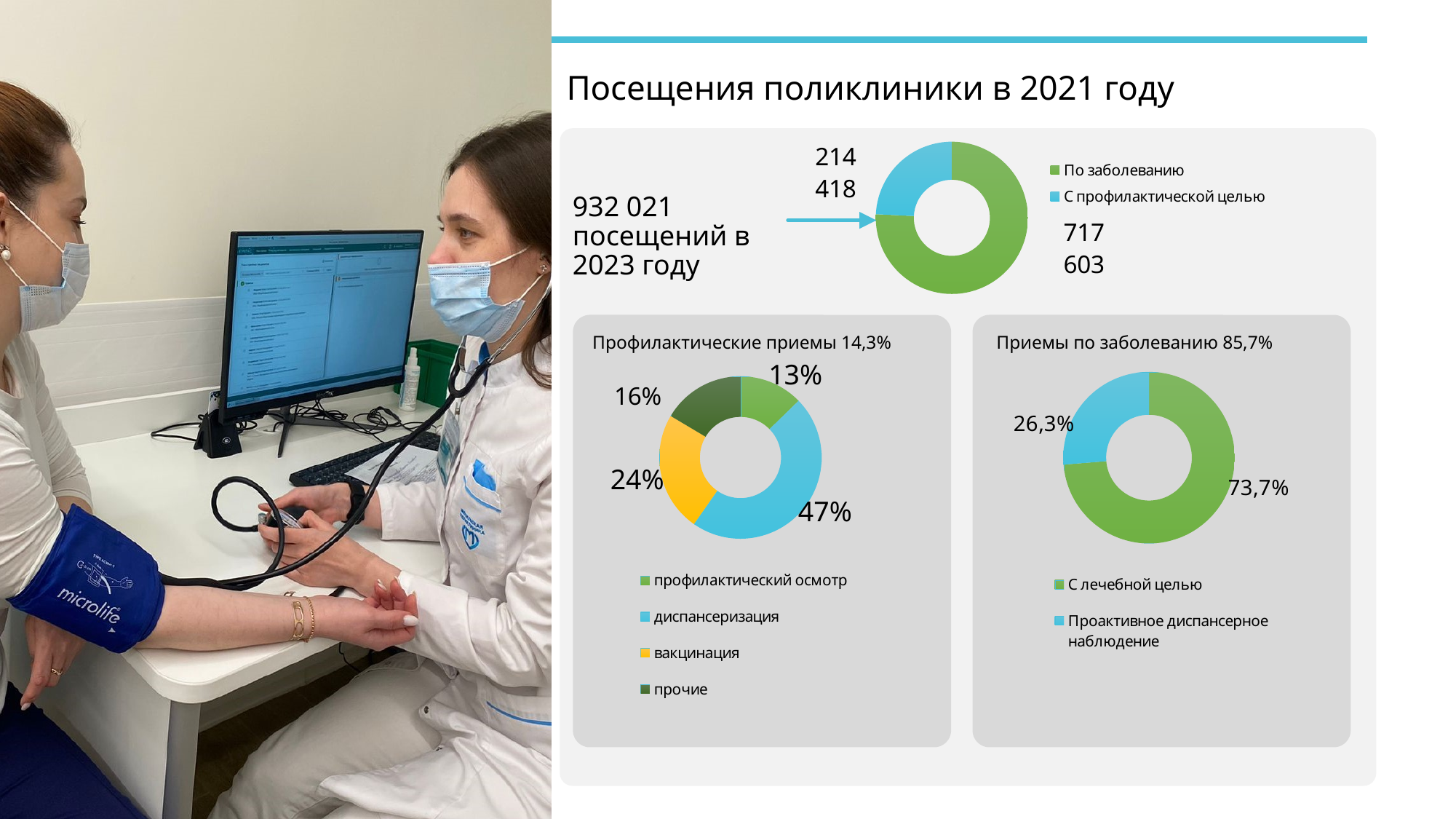
In the chart 'Профилактические приемы 14,3%', what share does 'диспансеризация' have? 47% In the chart 'Приемы по заболеванию 85,7%', what share does 'Проактивное диспансерное наблюдение' have? 26,3% In the top donut chart, what is the value for 'С профилактической целью'? 214 418 In the top donut chart, which category is larger: 'По заболеванию' or 'С профилактической целью'? По заболеванию How many categories does the legend of the chart 'Профилактические приемы 14,3%' list? 4 In the chart 'Профилактические приемы 14,3%', which category has the smallest share? профилактический осмотр In the chart 'Профилактические приемы 14,3%', what share does 'вакцинация' have? 24% What type of chart is used for 'Приемы по заболеванию 85,7%'? Donut (pie) chart In the chart 'Приемы по заболеванию 85,7%', what share does 'С лечебной целью' have? 73,7% In the top donut chart, what is the difference between 'По заболеванию' and 'С профилактической целью'? 503 185 In the chart 'Профилактические приемы 14,3%', which category has the largest share? диспансеризация In the top donut chart, what is the value for 'По заболеванию'? 717 603